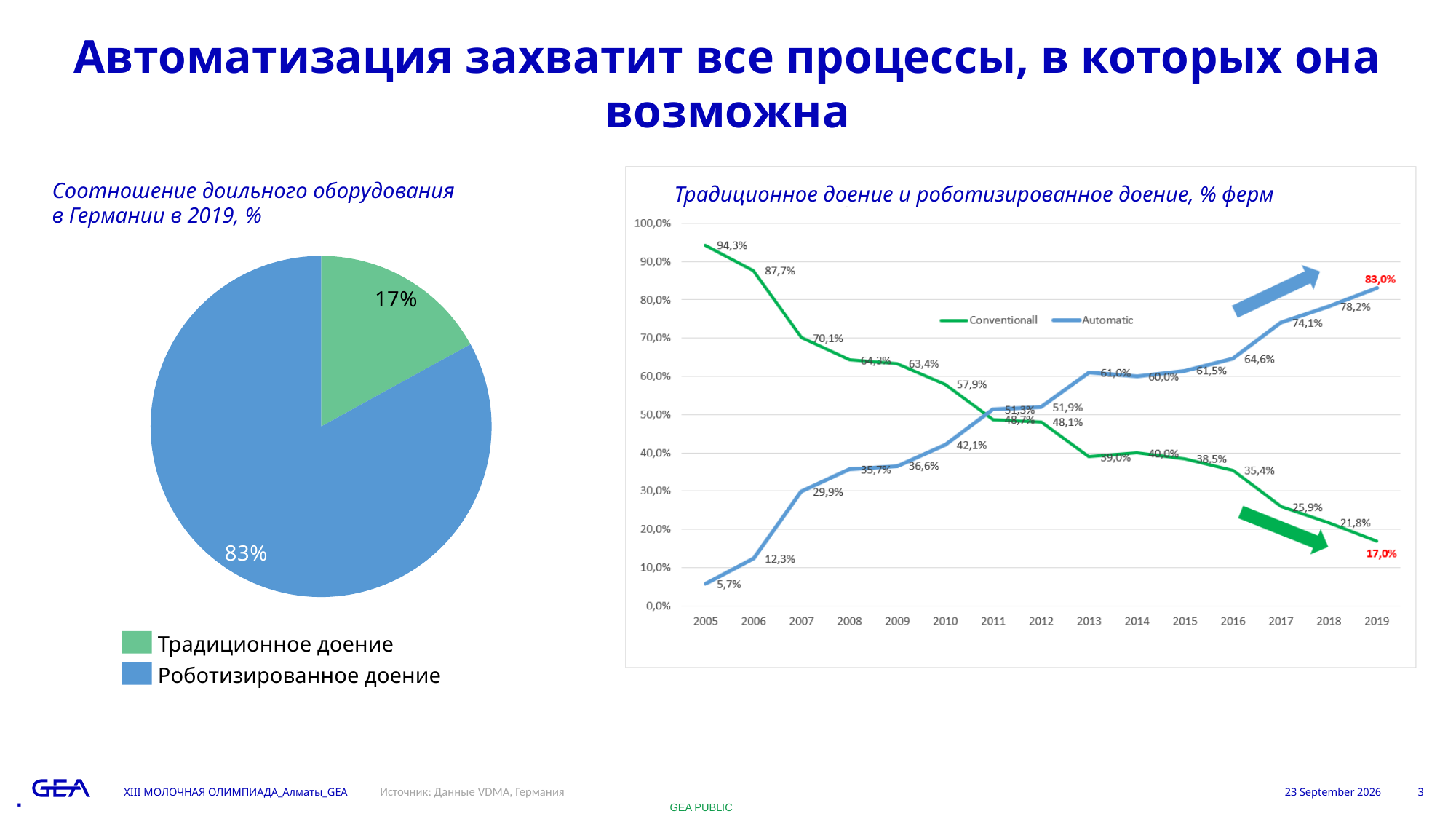
In the line chart on the right, how many series does the legend list? 2 In the line chart on the right, how many years are shown on the x axis? 15 In the line chart on the right, what is the value of the Automatic series in 2005? 5,7% In the line chart on the right, what is the difference between the Automatic value in 2019 and the Automatic value in 2005? 77,3% In the line chart on the right, what is the value of the Conventionall series in 2019? 17,0% In the pie chart on the left, what share is shown for Роботизированное доение? 83% What kind of chart is the chart on the right of the slide? Line chart What kind of chart is the chart on the left of the slide? Pie chart In the line chart on the right, which series has the higher value in 2008, Conventionall or Automatic? Conventionall In the line chart on the right, does the Conventionall series rise or fall from 2005 to 2019? Fall In the pie chart on the left, what share is shown for Традиционное доение? 17% In the line chart on the right, what is the value of the Automatic series in 2017? 74,1%